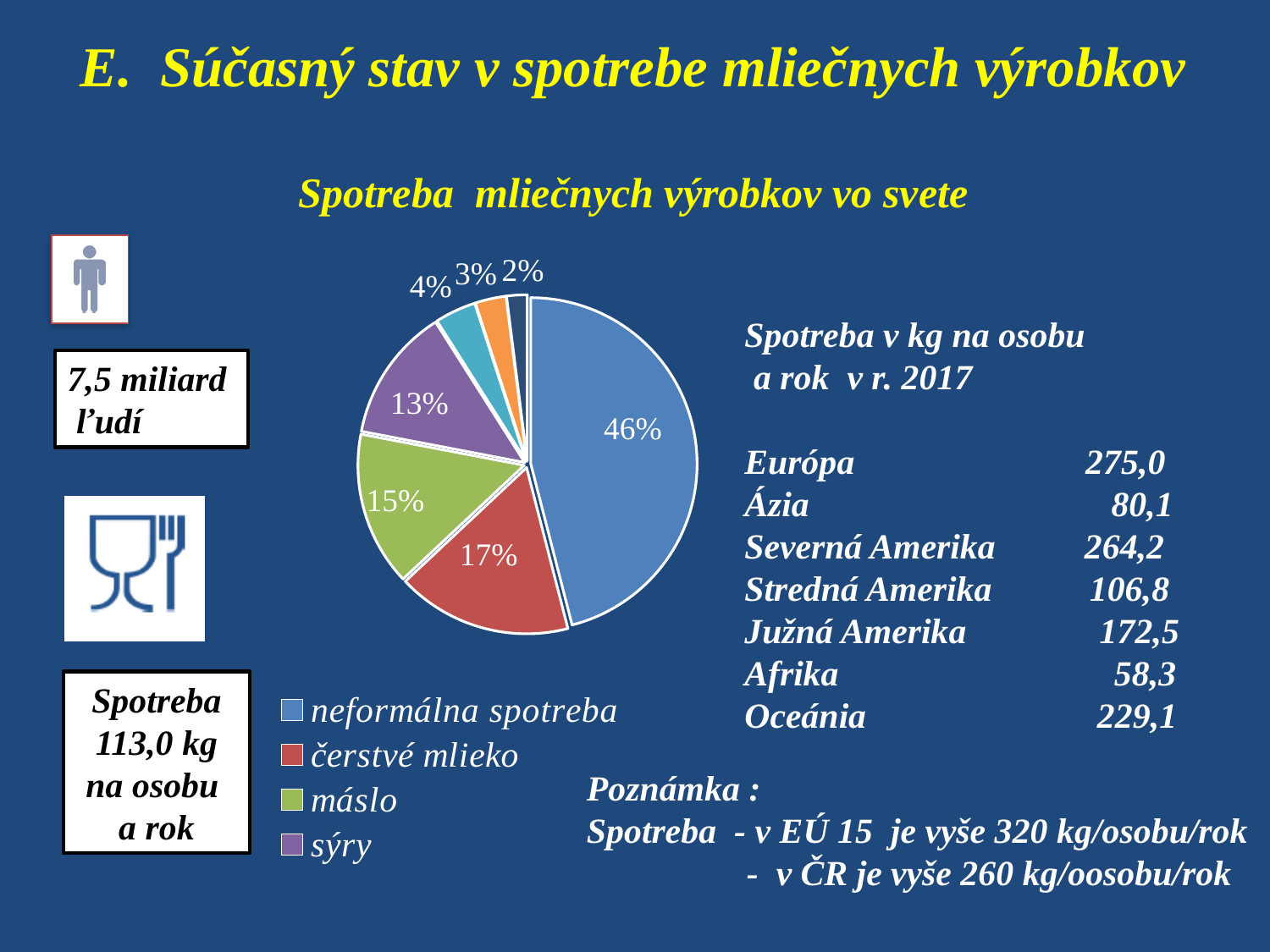
Which category has the largest slice of the pie? neformálna spotreba What kind of chart is shown on the slide? pie chart What share of the pie does "sýry" represent? 13% What share of the pie does "neformálna spotreba" represent? 46% How many entries does the legend list? 4 How many slices does the pie chart have? 7 Which is larger, the slice for "máslo" or the slice for "sýry"? máslo What is the percentage shown on the smallest slice of the pie? 2% What is the title shown above the pie chart? Spotreba mliečnych výrobkov vo svete What share of the pie does "máslo" represent? 15% What is the difference in percentage points between "neformálna spotreba" and "čerstvé mlieko"? 29